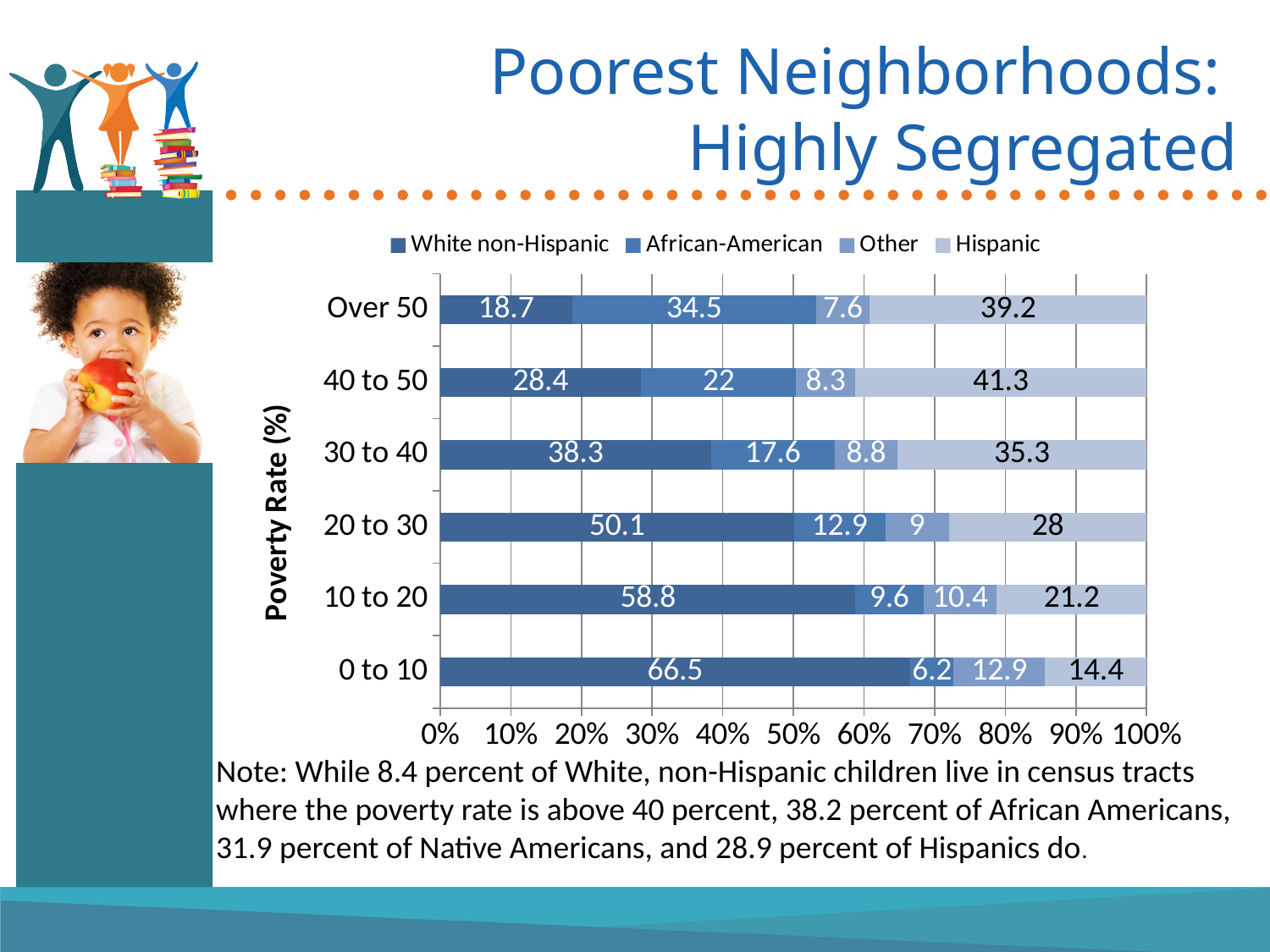
What is the Hispanic value for the 40 to 50 poverty rate category? 41.3 What is the African-American value for the Over 50 poverty rate category? 34.5 Which poverty rate category has the highest White non-Hispanic value? 0 to 10 What is the total of the stacked bar for the 20 to 30 poverty rate category? 100 What is the difference between the White non-Hispanic value for 0 to 10 and for Over 50? 47.8 As the poverty rate category increases from 0 to 10 to Over 50, does the White non-Hispanic value rise or fall? Fall In the Over 50 category, which is larger: the African-American value or the Hispanic value? Hispanic What kind of chart is shown on the slide? Stacked bar chart Which poverty rate category has the lowest Hispanic value? 0 to 10 What is the White non-Hispanic value for the 0 to 10 poverty rate category? 66.5 How many series does the legend list? 4 How many poverty rate categories are shown on the chart? 6